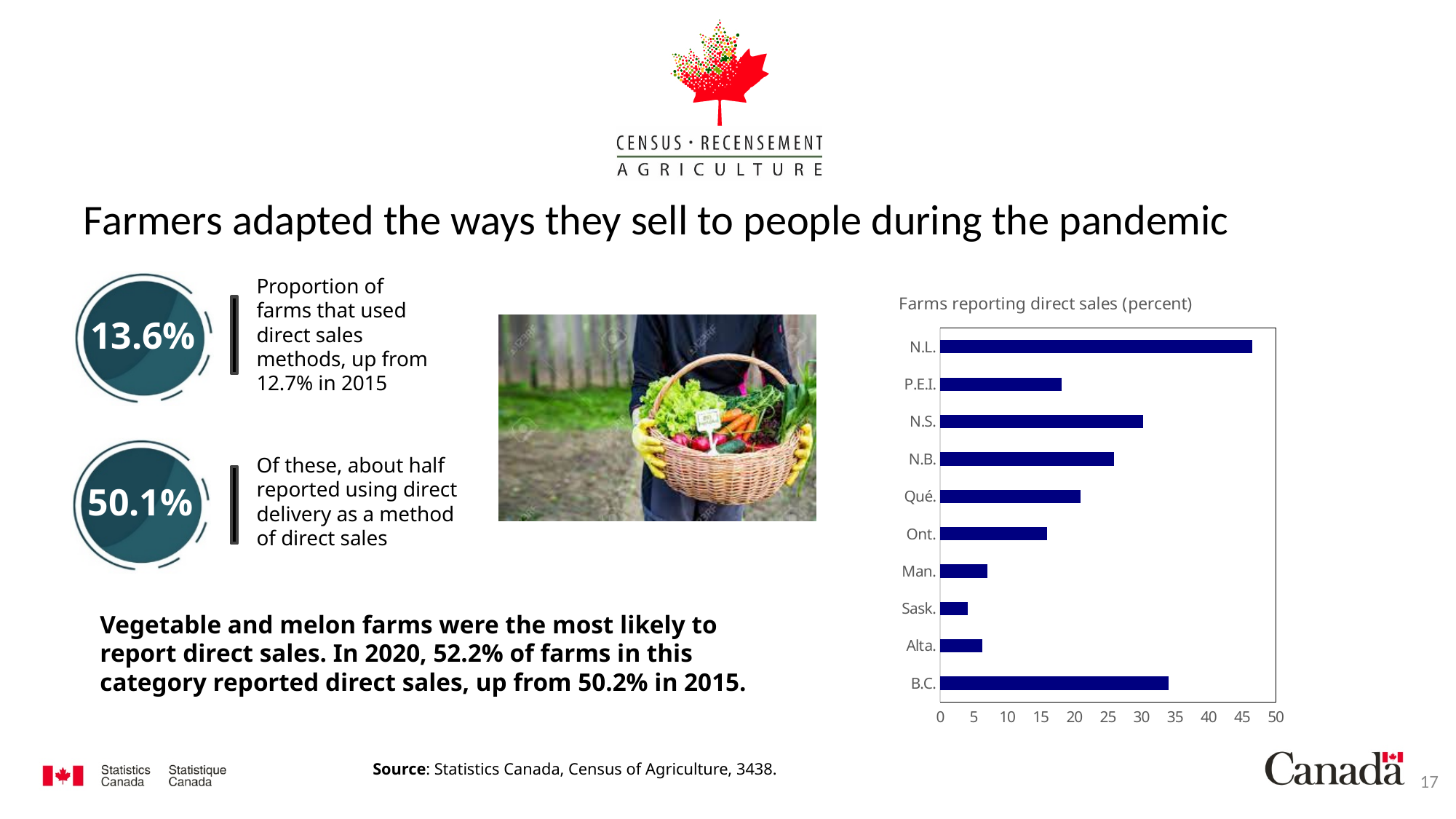
What is the maximum value shown on the horizontal axis of the chart? 50 Is the value for B.C. greater or less than 30? greater Is the value for Sask. greater or less than 10? less Which has a higher percentage of farms reporting direct sales, P.E.I. or N.B.? N.B. Which has a higher percentage of farms reporting direct sales, N.S. or B.C.? B.C. What is the title of the chart? Farms reporting direct sales (percent) Which province has the lowest percentage of farms reporting direct sales? Sask. What kind of chart is shown on the slide? bar chart How many provinces are shown in the chart? 10 Is the value for Ont. greater or less than 20? less Which province has the highest percentage of farms reporting direct sales? N.L.